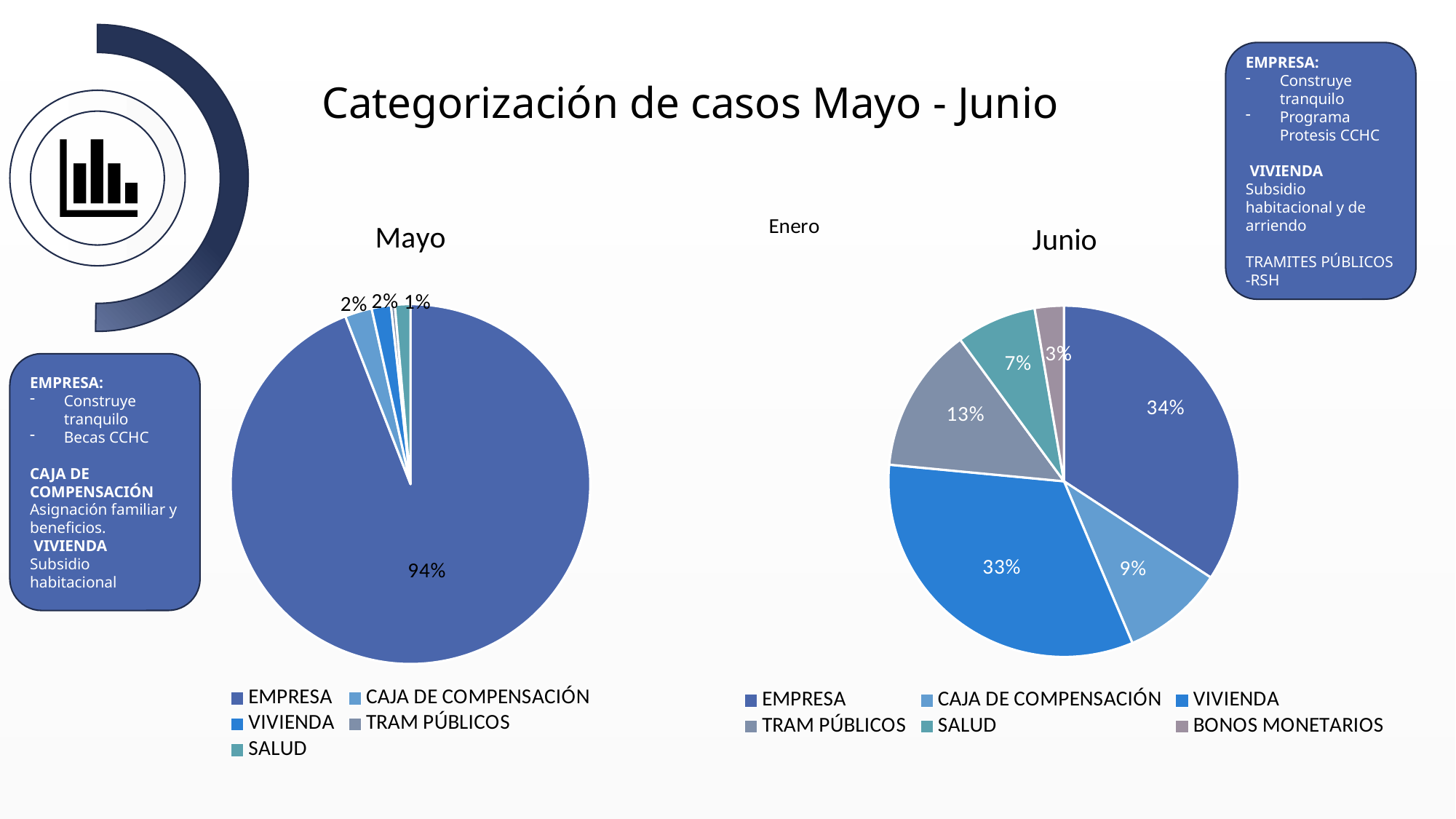
How many categories does the legend of the Junio pie chart list? 6 In the Junio pie chart, what share is shown for BONOS MONETARIOS? 3% In the Junio pie chart, what share is shown for SALUD? 7% In the Junio pie chart, what share is shown for VIVIENDA? 33% In the Junio pie chart, which category has the smallest slice? BONOS MONETARIOS In the Junio pie chart, how many percentage points larger is TRAM PÚBLICOS than SALUD? 6 percentage points What kind of chart is used for Mayo and Junio? Pie chart In the Junio pie chart, which category has the largest slice? EMPRESA